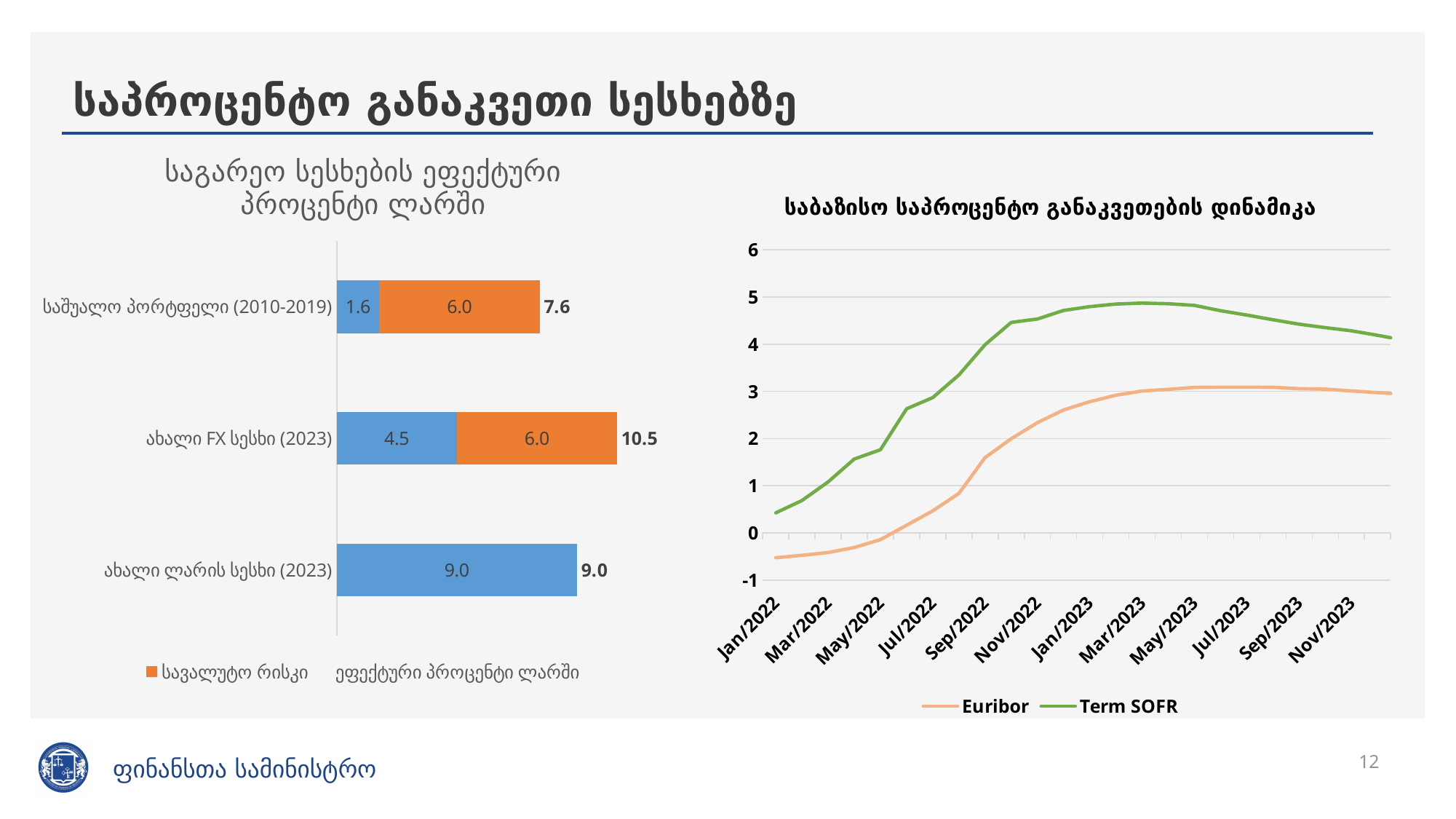
On the left bar chart, what is the total value shown for ახალი FX სესხი (2023)? 10.5 What kind of chart is the left chart titled საგარეო სესხების ეფექტური პროცენტი ლარში? Bar chart On the left bar chart, what is the ეფექტური პროცენტი ლარში value for საშუალო პორტფელი (2010-2019)? 7.6 On the right line chart, is the Term SOFR value for Mar/2023 greater or less than 4? greater On the left bar chart, what is the სავალუტო რისკი value for ახალი FX სესხი (2023)? 6.0 On the right line chart, how many series does the legend list? 2 On the right line chart, which series is higher at Nov/2023, Euribor or Term SOFR? Term SOFR On the left bar chart, which category has the highest total value? ახალი FX სესხი (2023) On the left bar chart, what is the difference between the total for ახალი FX სესხი (2023) and the total for ახალი ლარის სესხი (2023)? 1.5 On the right line chart, is the Euribor value for Jan/2022 greater or less than 0? less On the left bar chart, how many categories are shown? 3 On the left bar chart, which category has the lowest total value? საშუალო პორტფელი (2010-2019)